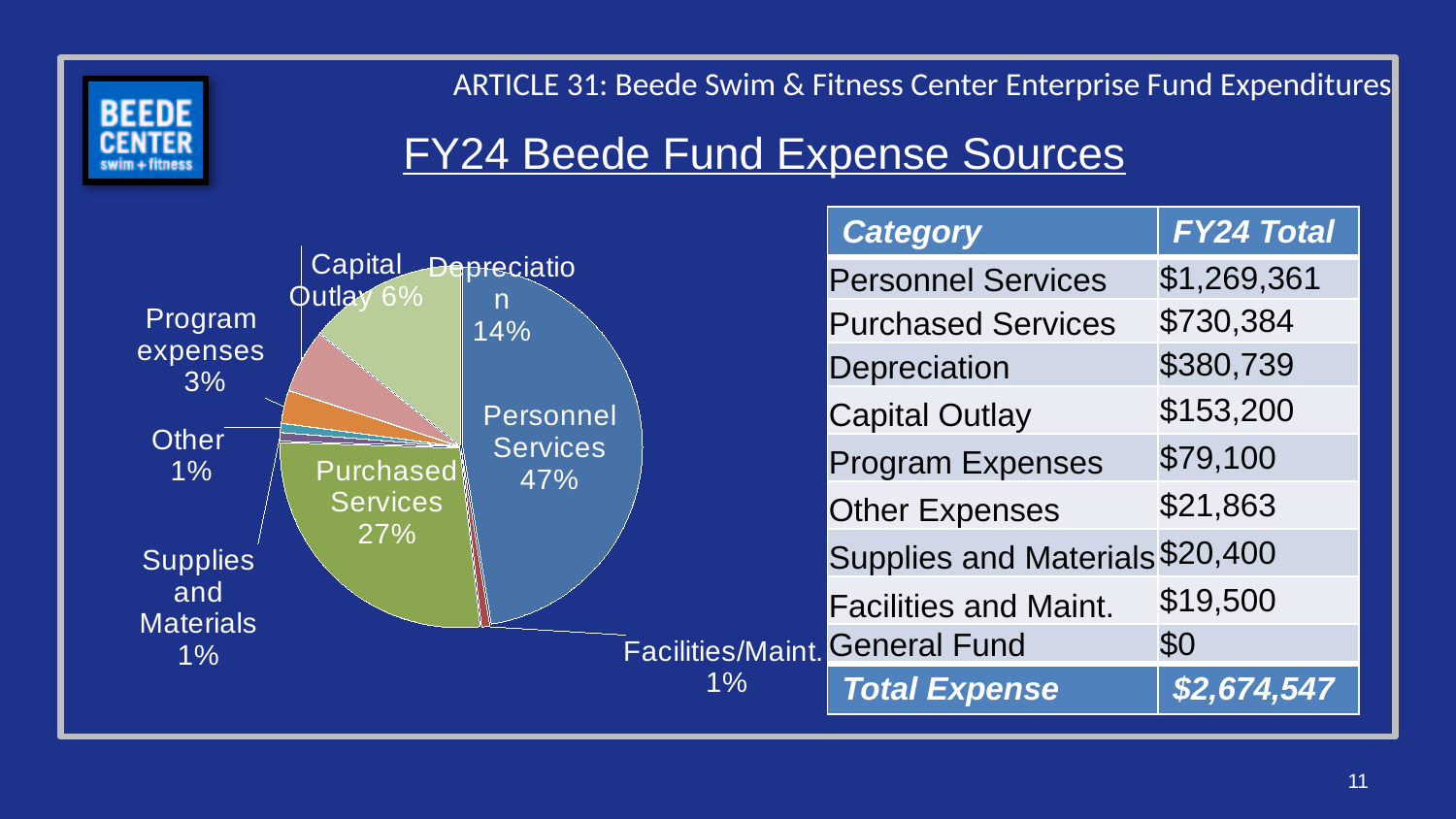
How many labeled slices does the pie chart have? 8 What share of the pie does Personnel Services represent? 47% What is the difference in percentage points between Personnel Services and Purchased Services in the pie chart? 20 What share of the pie does Purchased Services represent? 27% What type of chart is shown on the slide? Pie chart What percentage is shown for Capital Outlay in the pie chart? 6% Which category has the largest slice of the pie chart? Personnel Services What percentage is shown for Program expenses in the pie chart? 3% Which is larger in the pie chart, Purchased Services or Depreciation? Purchased Services What is the title of the chart on the slide? FY24 Beede Fund Expense Sources What percentage is shown for Depreciation in the pie chart? 14% What percentage is shown for Facilities/Maint. in the pie chart? 1%